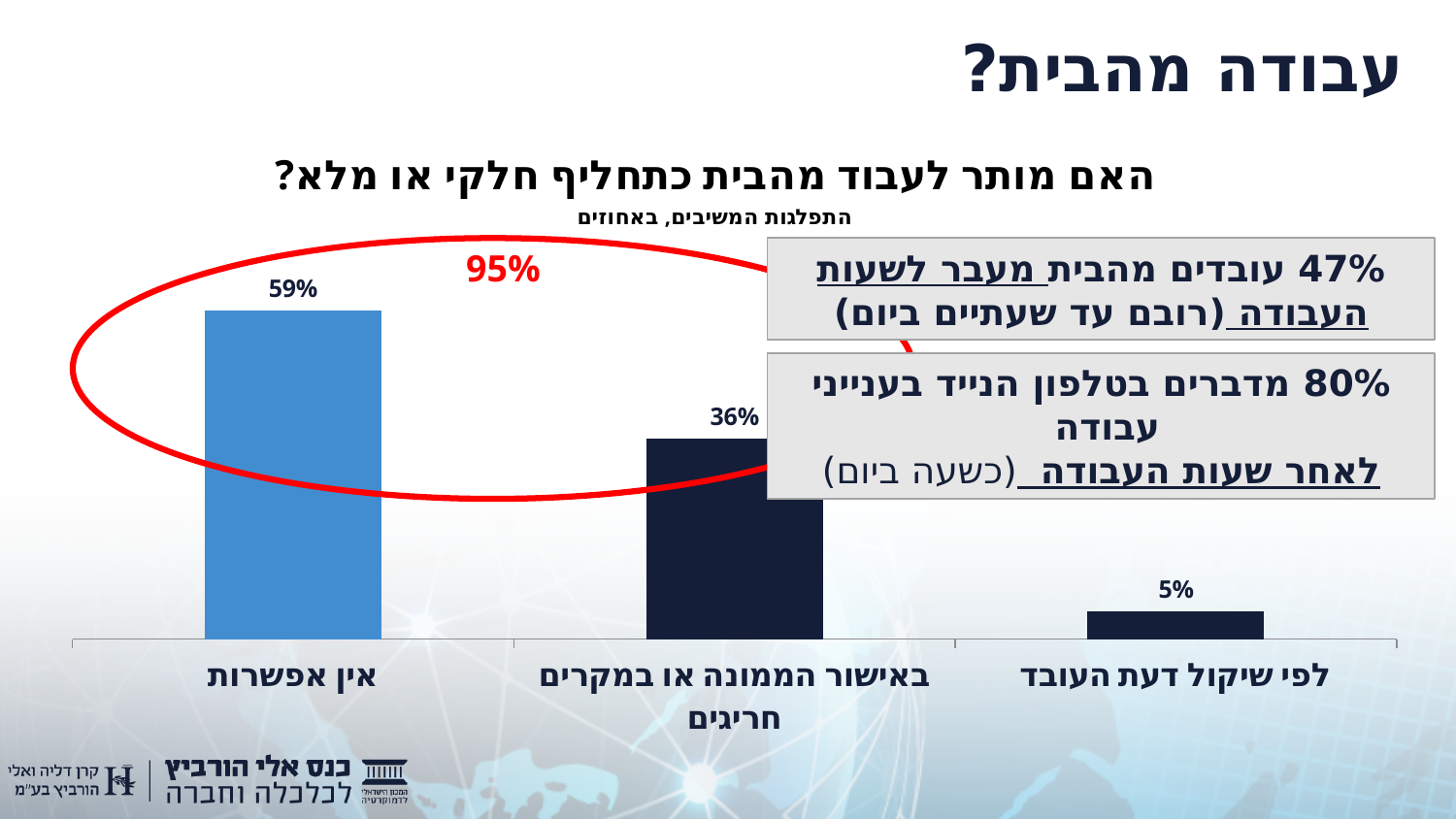
What percentage of respondents answered "אין אפשרות"? 59% Which category has the lowest value? לפי שיקול דעת העובד What is the combined value of the two categories circled in red ("אין אפשרות" and "באישור הממונה או במקרים חריגים")? 95% What is the value for "באישור הממונה או במקרים חריגים"? 36% What is the difference between the values for "באישור הממונה או במקרים חריגים" and "לפי שיקול דעת העובד"? 31% How many categories are shown in the chart? 3 What is the difference between the values for "אין אפשרות" and "באישור הממונה או במקרים חריגים"? 23% What is the title of the chart? האם מותר לעבוד מהבית כתחליף חלקי או מלא? Which category has the highest value? אין אפשרות What kind of chart is shown on the slide? Bar chart What is the value for "לפי שיקול דעת העובד"? 5% Which is larger: the value for "אין אפשרות" or the value for "לפי שיקול דעת העובד"? אין אפשרות